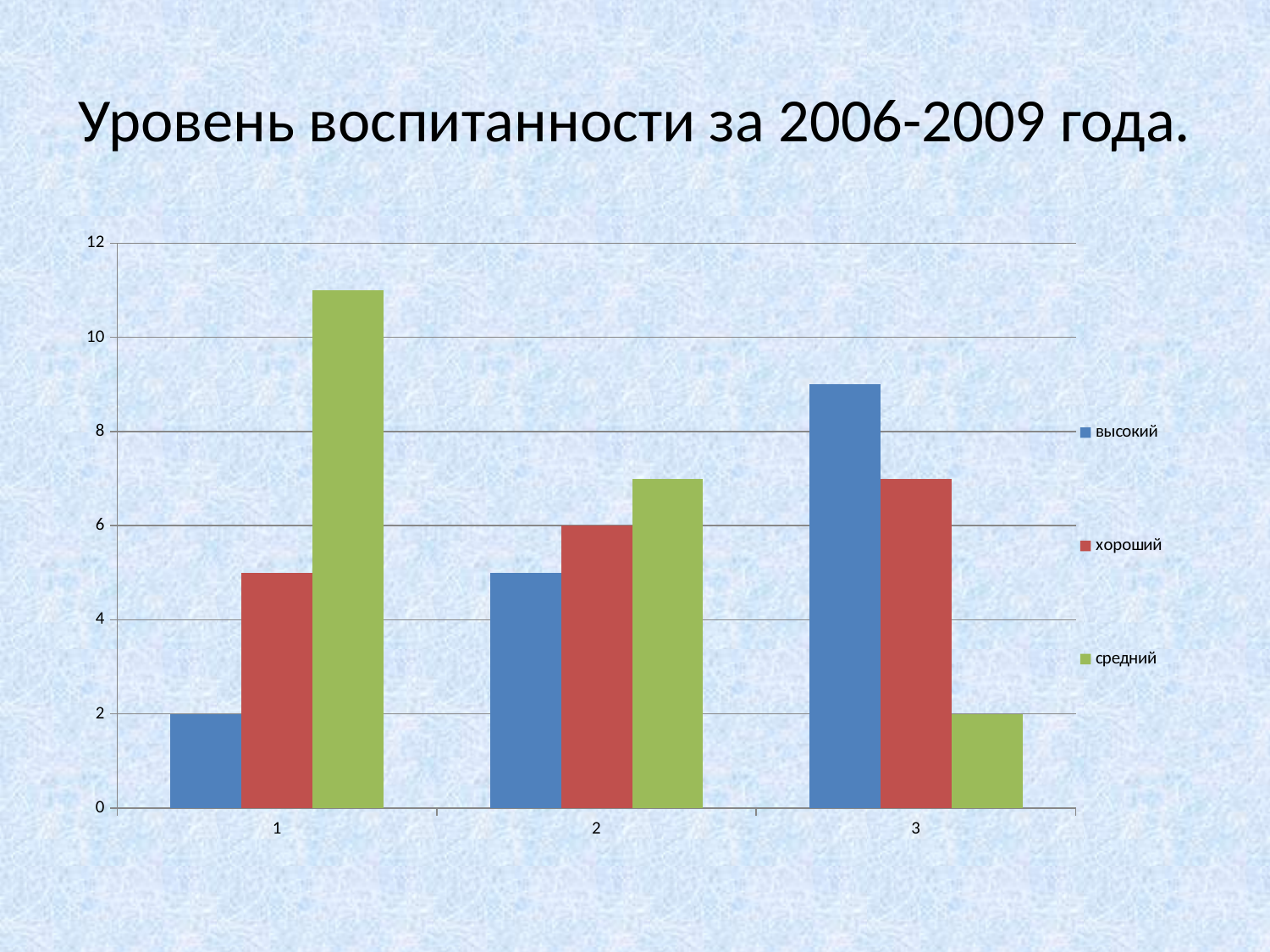
For which category is the высокий series highest? 3 Is the value of the средний series for category 1 greater or less than 10? greater What is the value of the средний series for category 3? 2 For which category is the средний series lowest? 3 What is the value of the хороший series for category 2? 6 Is the value of the высокий series for category 3 greater or less than 8? greater How many series does the legend list? 3 How many categories are shown on the x axis? 3 What is the value of the высокий series for category 1? 2 Which series has the larger value for category 1, высокий or средний? средний Is the value of the высокий series for category 2 greater or less than 6? less What kind of chart is shown on the slide? bar chart